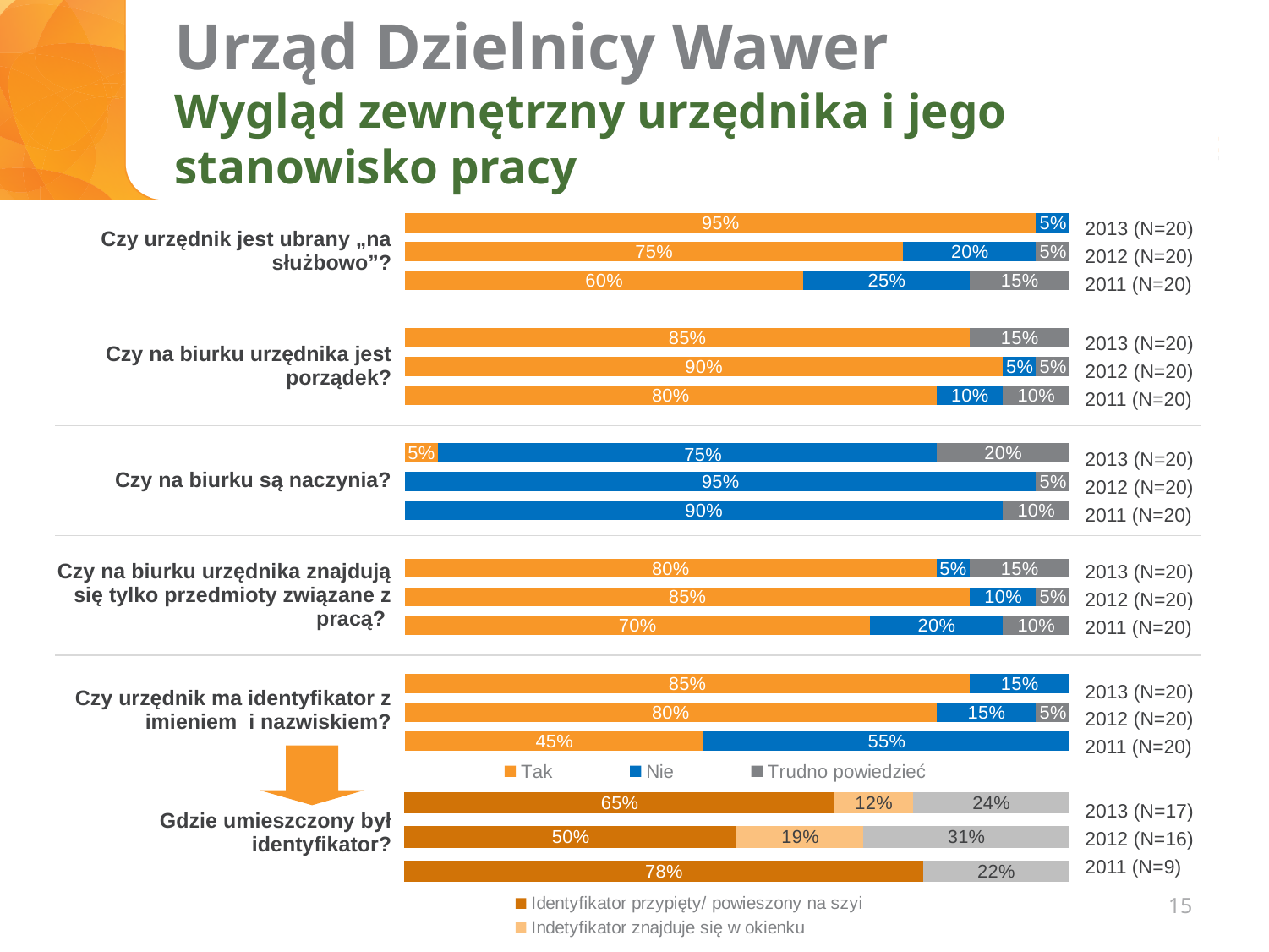
In the chart for "Czy urzędnik ma identyfikator z imieniem i nazwiskiem?", what is the "Nie" share for 2011? 55% In the chart for "Gdzie umieszczony był identyfikator?", what percentage in 2011 had the identifier pinned/hung on the neck ("Identyfikator przypięty/ powieszony na szyi")? 78% In the chart for "Czy na biurku są naczynia?", what is the "Tak" share for 2013? 5% What type of chart is used on this slide? Stacked bar chart In the chart for "Czy urzędnik jest ubrany „na służbowo”?", what percentage answered "Tak" in 2013? 95% In the chart for "Czy urzędnik ma identyfikator z imieniem i nazwiskiem?", is the "Tak" share for 2013 larger or smaller than for 2011? larger In the chart for "Czy na biurku urzędnika znajdują się tylko przedmioty związane z pracą?", which year has the lowest "Tak" share? 2011 In the chart for "Czy na biurku są naczynia?", what is the "Nie" share for 2012? 95% In the chart for "Czy urzędnik jest ubrany „na służbowo”?", by how many percentage points did the "Tak" share change from 2011 to 2013? 35 percentage points In the chart for "Czy urzędnik jest ubrany „na służbowo”?", what is the "Nie" share for 2011? 25% In the chart for "Czy na biurku urzędnika jest porządek?", which year has the highest "Tak" share? 2012 In the chart for "Gdzie umieszczony był identyfikator?", what is the sample size (N) for 2012? N=16